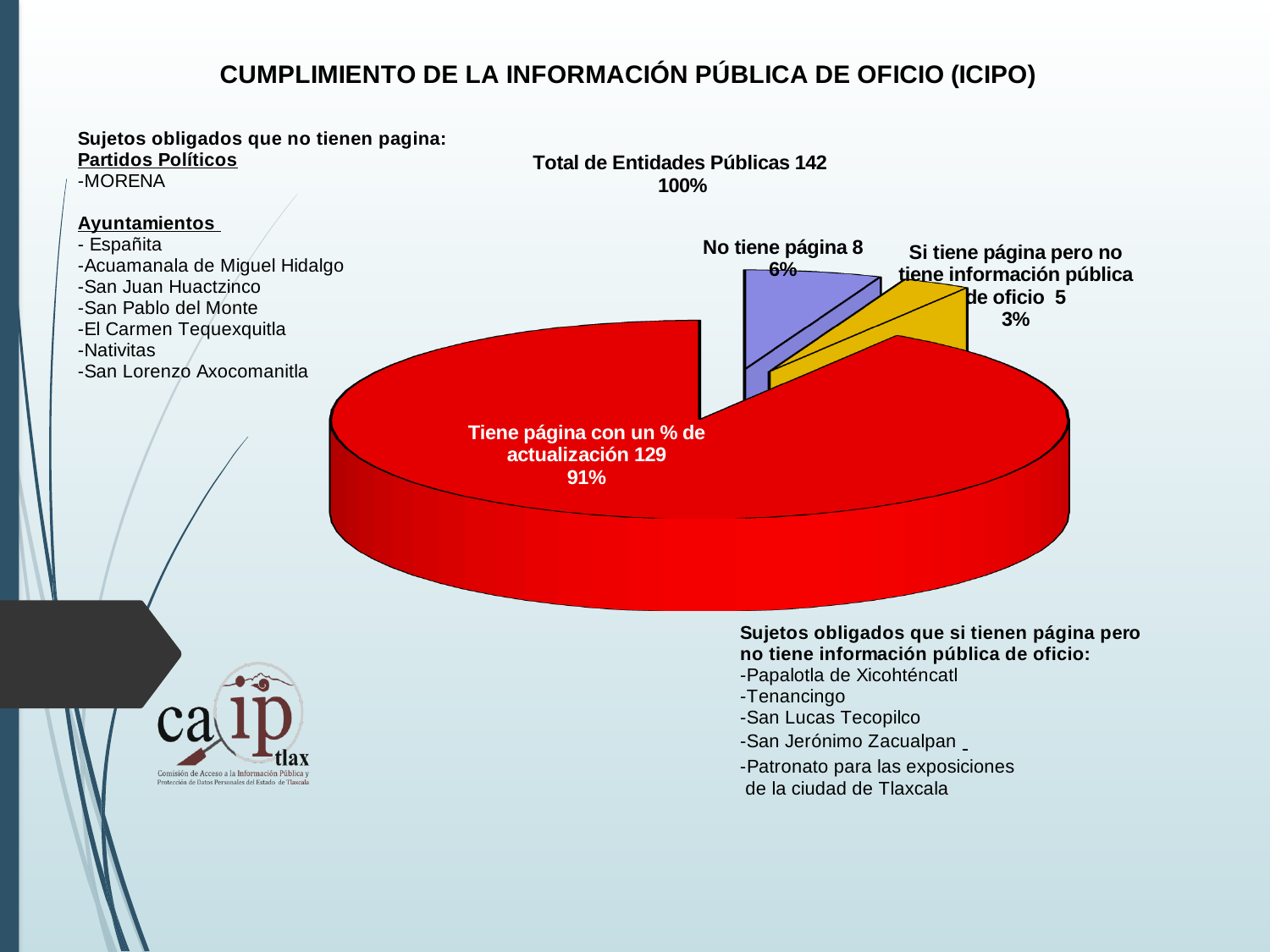
What is the difference in number of entities between 'No tiene página' and 'Si tiene página pero no tiene información pública de oficio'? 3 What percentage share does the slice 'No tiene página' have? 6% What kind of chart is shown on the slide? Pie chart Which slice of the pie chart is the smallest? Si tiene página pero no tiene información pública de oficio What percentage share does the slice 'Si tiene página pero no tiene información pública de oficio' have? 3% How many entities are in the 'Si tiene página pero no tiene información pública de oficio' slice? 5 How many entities are in the 'Tiene página con un % de actualización' slice? 129 How many slices does the pie chart have? 3 Which slice of the pie chart is the largest? Tiene página con un % de actualización How many entities are in the 'No tiene página' slice? 8 What percentage share does the slice 'Tiene página con un % de actualización' have? 91% What is the title of the pie chart? CUMPLIMIENTO DE LA INFORMACIÓN PÚBLICA DE OFICIO (ICIPO)